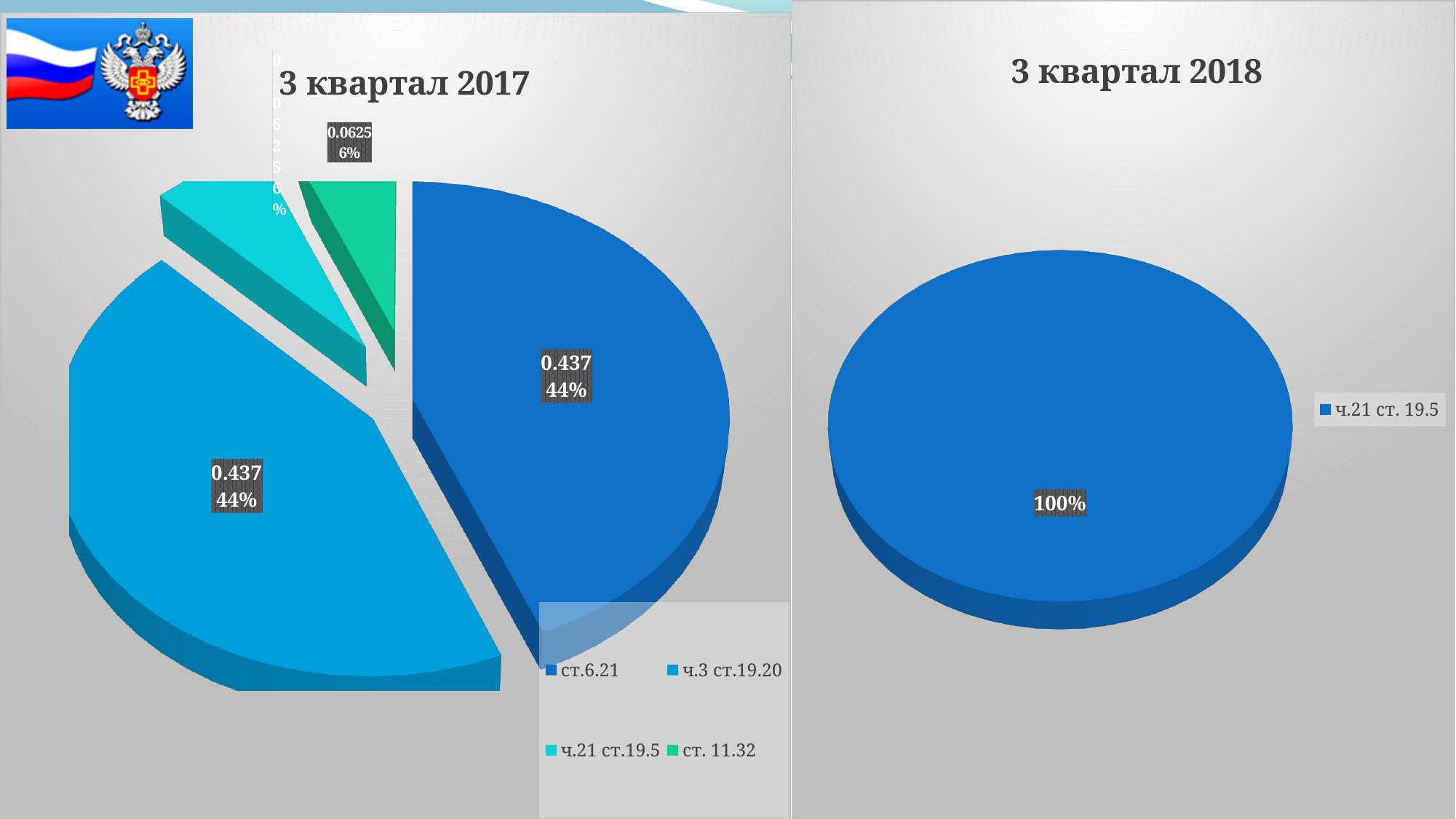
In the "3 квартал 2017" chart, what share of the pie does ст. 11.32 take? 6% In the "3 квартал 2017" chart, what value is labelled on the ст. 11.32 slice? 0.0625 How many entries does the legend of the "3 квартал 2018" chart list? 1 In the "3 квартал 2017" chart, what share of the pie does ч.3 ст.19.20 take? 44% In the "3 квартал 2017" chart, how many entries does the legend list? 4 What kind of chart is the "3 квартал 2017" chart? pie chart In the "3 квартал 2017" chart, what value is labelled on the ст.6.21 slice? 0.437 In the "3 квартал 2017" chart, which is larger, the slice for ст.6.21 or the slice for ст. 11.32? ст.6.21 What is the title of the chart on the right side of the slide? 3 квартал 2018 In the "3 квартал 2017" chart, what share of the pie does ст.6.21 take? 44% In the "3 квартал 2017" chart, what is the difference in percentage share between ст.6.21 and ст. 11.32? 38%